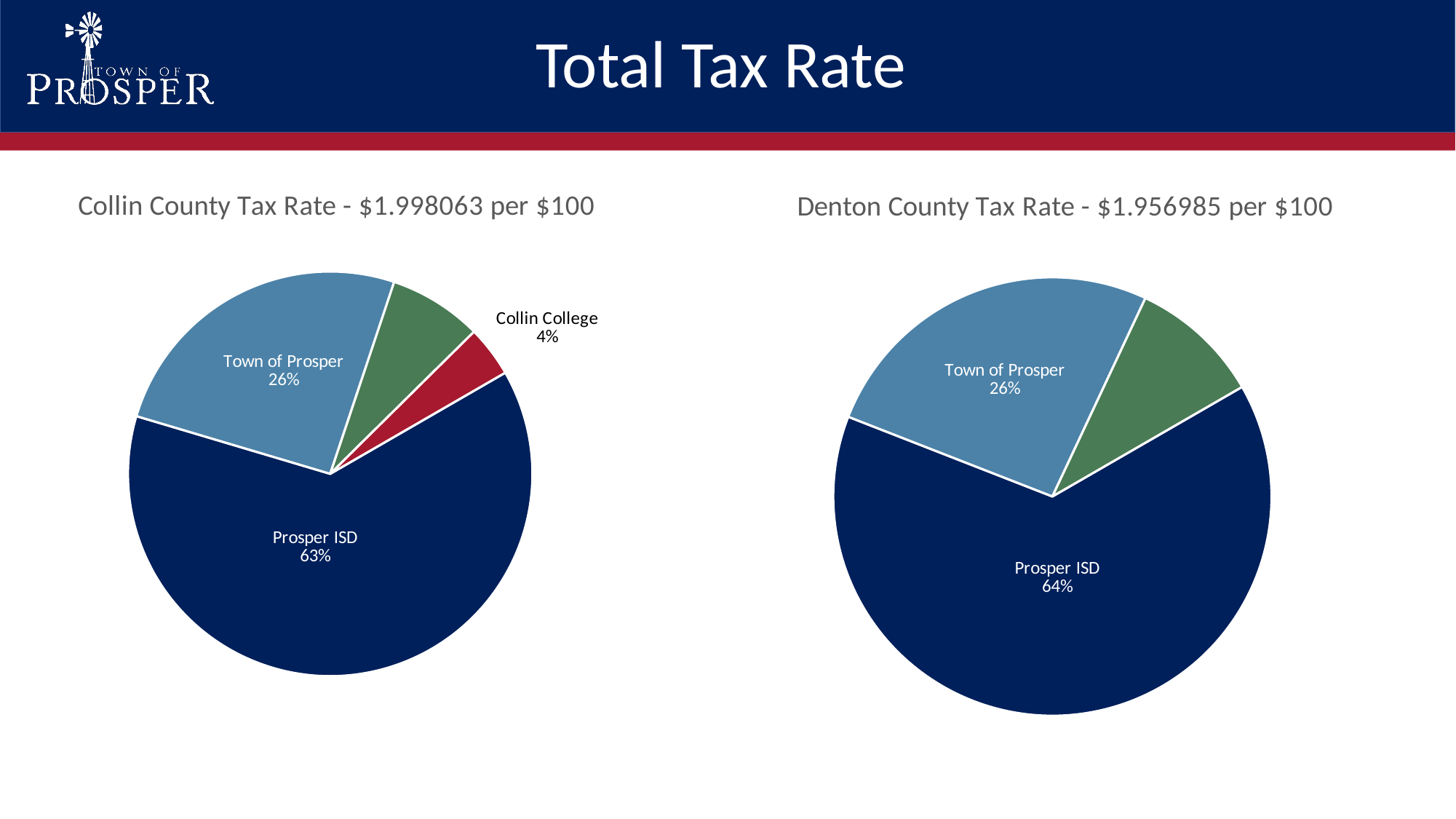
What kind of chart is used for the Collin County Tax Rate? Pie chart In the Collin County Tax Rate chart, what share does Collin College have? 4% Which chart shows a larger share for Prosper ISD, the Collin County chart or the Denton County chart? Denton County In the Denton County Tax Rate chart, what share does the Town of Prosper have? 26% In the Collin County Tax Rate chart, which labelled slice is the largest? Prosper ISD In the Collin County Tax Rate chart, how many percentage points larger is Prosper ISD's share than the Town of Prosper's share? 37 In the Denton County Tax Rate chart, how many percentage points larger is Prosper ISD's share than the Town of Prosper's share? 38 In the Collin County Tax Rate chart, which labelled slice is the smallest? Collin College In the Denton County Tax Rate chart, what share does Prosper ISD have? 64% In the Collin County Tax Rate chart, what share does Prosper ISD have? 63% In the Collin County Tax Rate chart, what share does the Town of Prosper have? 26% What is the title of the chart on the right side of the slide? Denton County Tax Rate - $1.956985 per $100